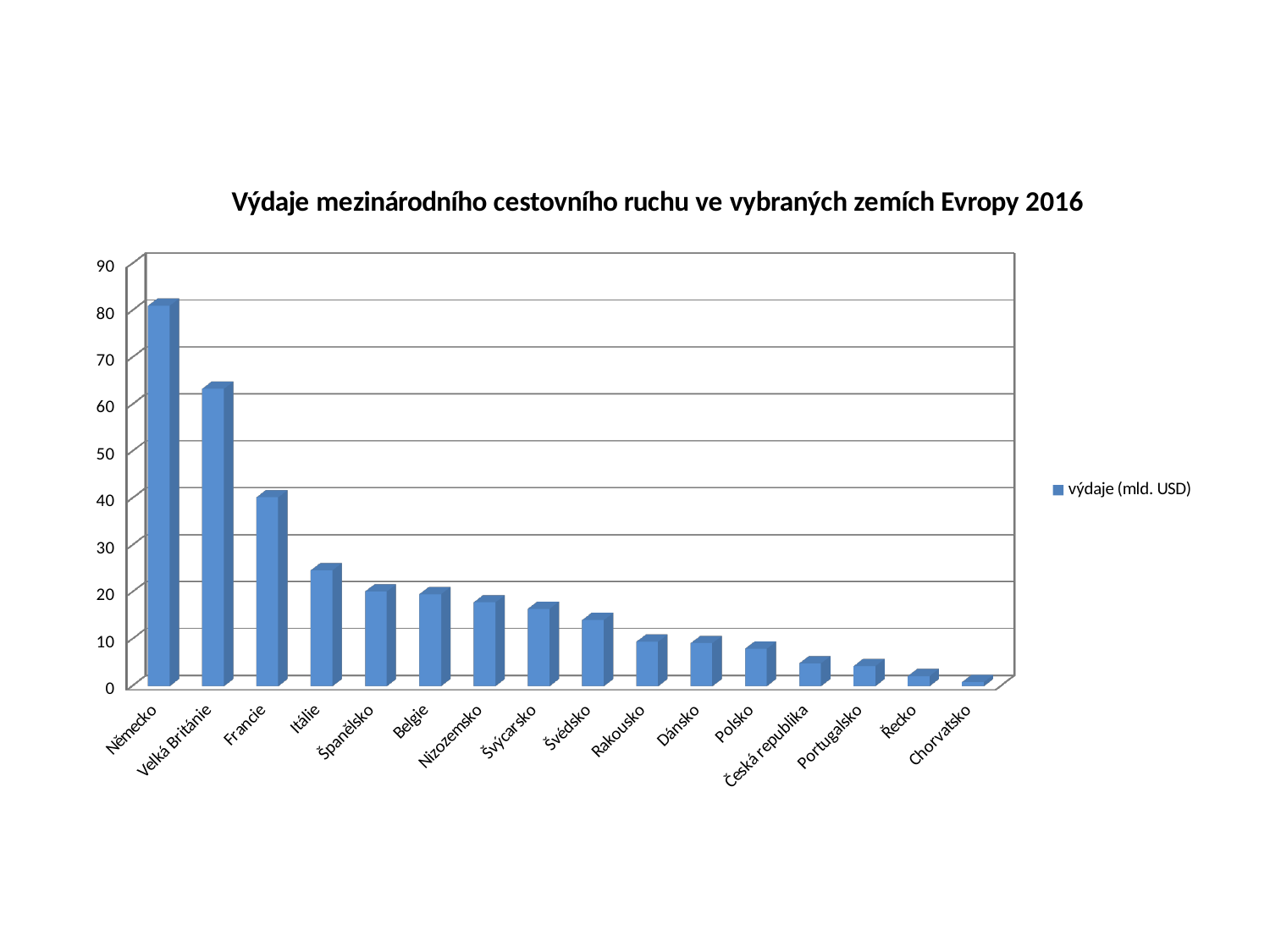
How many series does the legend list? 1 What kind of chart is shown on the slide? bar chart Which country has the highest value in the chart? Německo Which country has the lowest value in the chart? Chorvatsko Is the value for Německo greater or less than 70? greater Is the value for Švédsko greater or less than 10? greater Is the value for Velká Británie greater or less than 50? greater Do the values rise or fall moving from left to right along the x axis? fall How many countries are shown on the x axis of the chart? 16 Which is larger, the value for Francie or the value for Španělsko? Francie